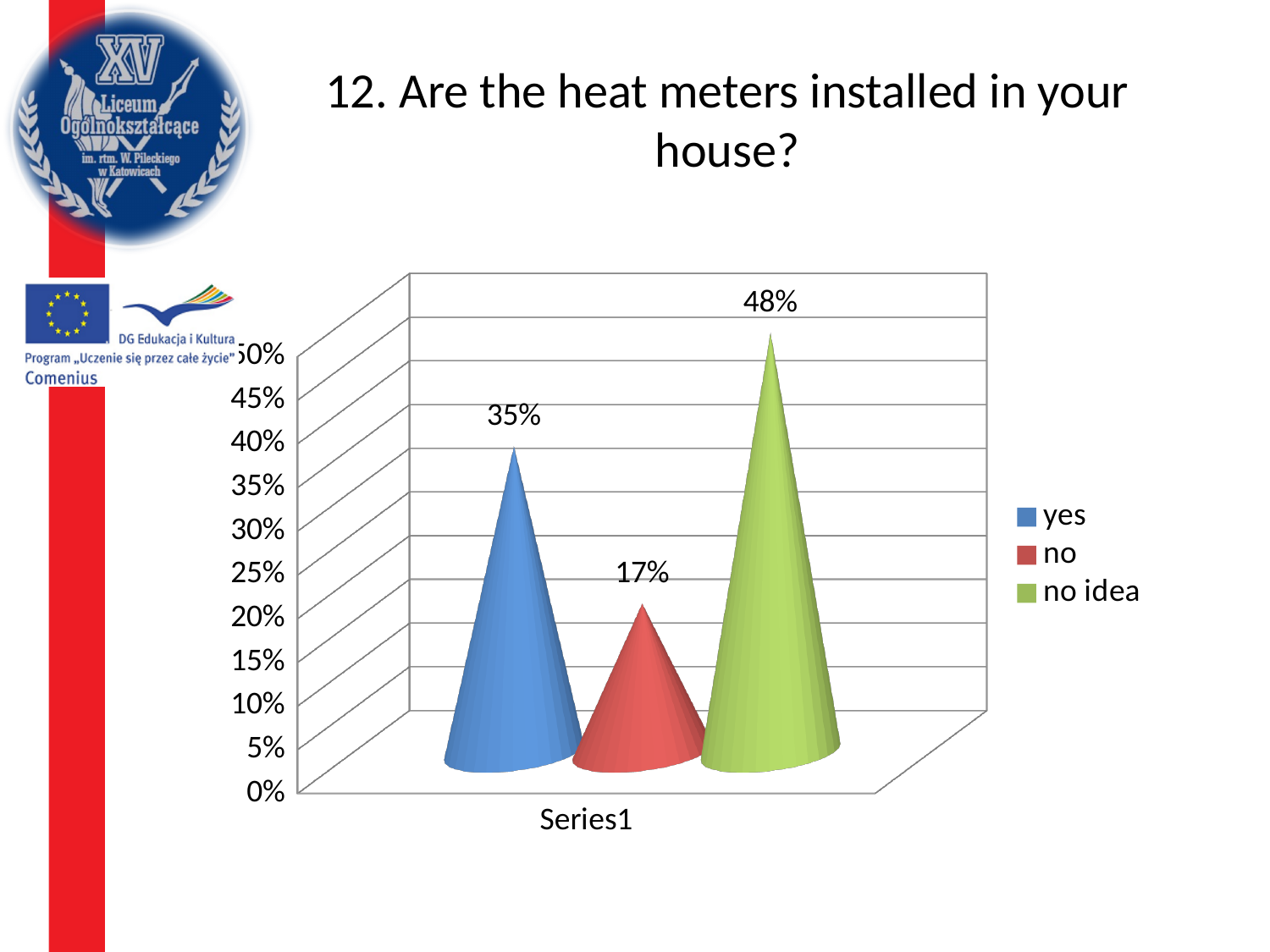
What is the difference in percentage points between "yes" and "no"? 18% What colour represents the "no idea" answer in the chart? green What percentage of respondents answered "no"? 17% What percentage of respondents answered "yes"? 35% How many entries does the legend list? 3 Which answer has the lowest percentage? no Is the value for "no idea" greater or less than 40%? greater How many answer options are plotted in the chart? 3 What percentage of respondents answered "no idea"? 48% What is the difference in percentage points between "no idea" and "yes"? 13% Which answer has the highest percentage? no idea Which is larger, the value for "yes" or the value for "no"? yes